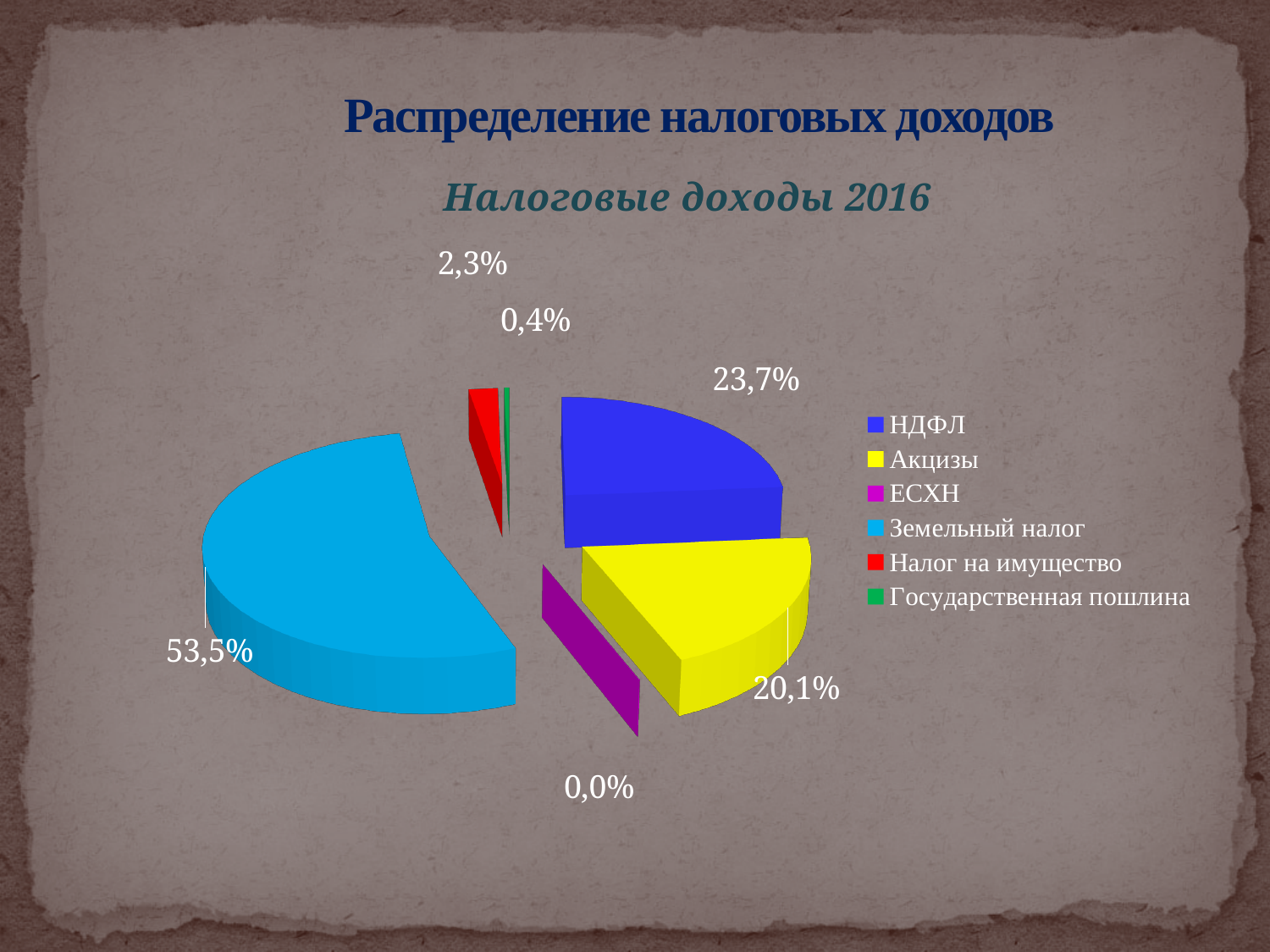
What share of the pie does Государственная пошлина have? 0,4% What share of the pie does Земельный налог have? 53,5% What share of the pie does Налог на имущество have? 2,3% What is the difference between the shares for Земельный налог and НДФЛ? 29,8% What share of the pie does ЕСХН have? 0,0% Which category has the largest share of the pie? Земельный налог Which is larger, the share for НДФЛ or the share for Акцизы? НДФЛ What is the title of the chart? Налоговые доходы 2016 What share of the pie does Акцизы have? 20,1% What type of chart is shown on the slide? pie chart How many categories does the legend list? 6 What share of the pie does НДФЛ have? 23,7%